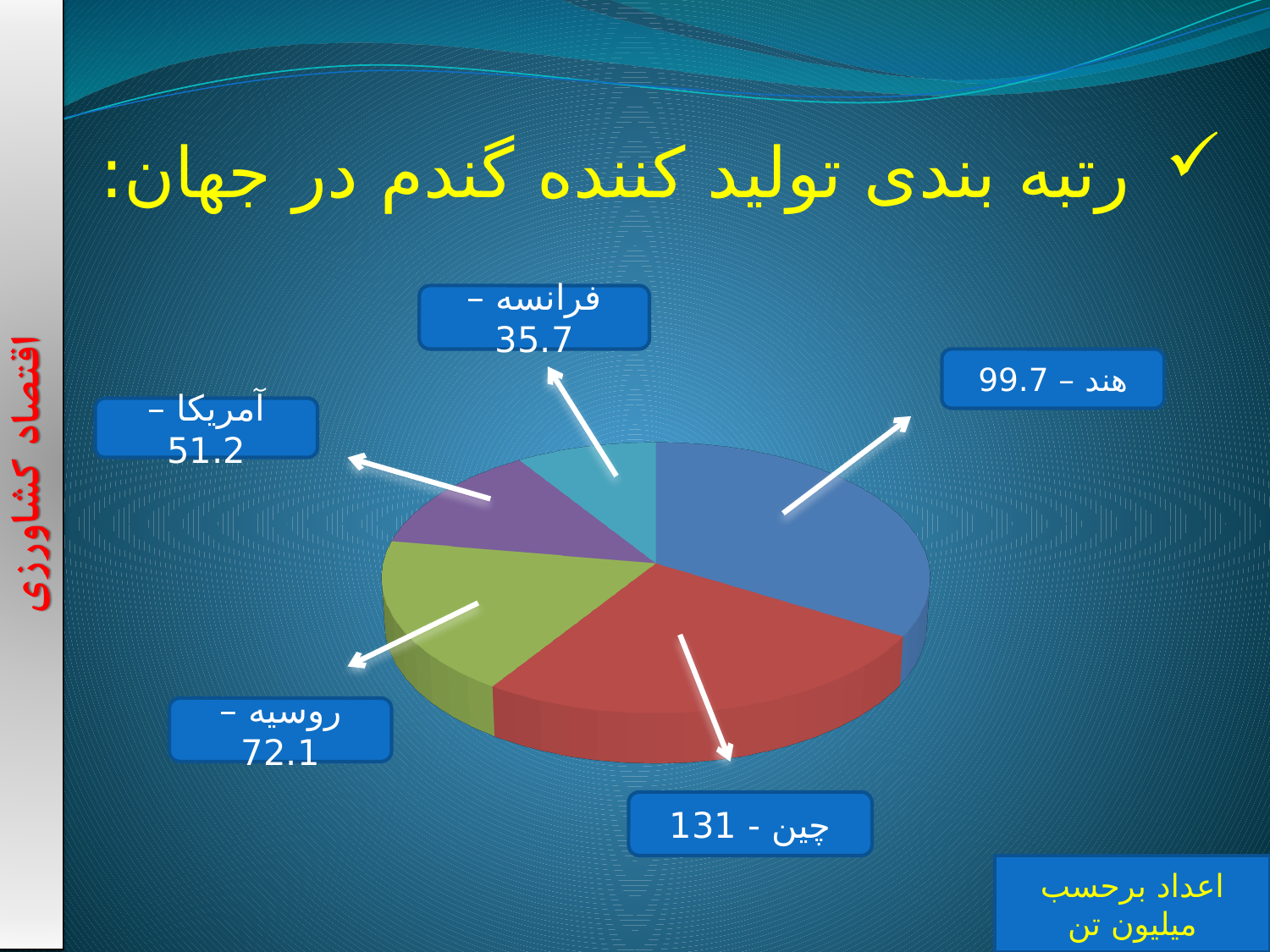
How many countries (slices) are shown in the pie chart? 5 What is the value labelled for چین (China) in the pie chart? 131 What is the value labelled for روسیه (Russia) in the pie chart? 72.1 What kind of chart is shown on the slide? Pie chart Which has the larger labelled value, روسیه (Russia) or آمریکا (USA)? روسیه (Russia) According to the note on the slide, what unit are the numbers in the chart expressed in? میلیون تن (million tons) Which country has the lowest labelled value in the pie chart? فرانسه (France) What is the value labelled for فرانسه (France) in the pie chart? 35.7 What is the value labelled for آمریکا (USA) in the pie chart? 51.2 What is the difference between the labelled values for چین (China) and هند (India)? 31.3 Which country has the highest labelled value in the pie chart? چین (China) What is the value labelled for هند (India) in the pie chart? 99.7